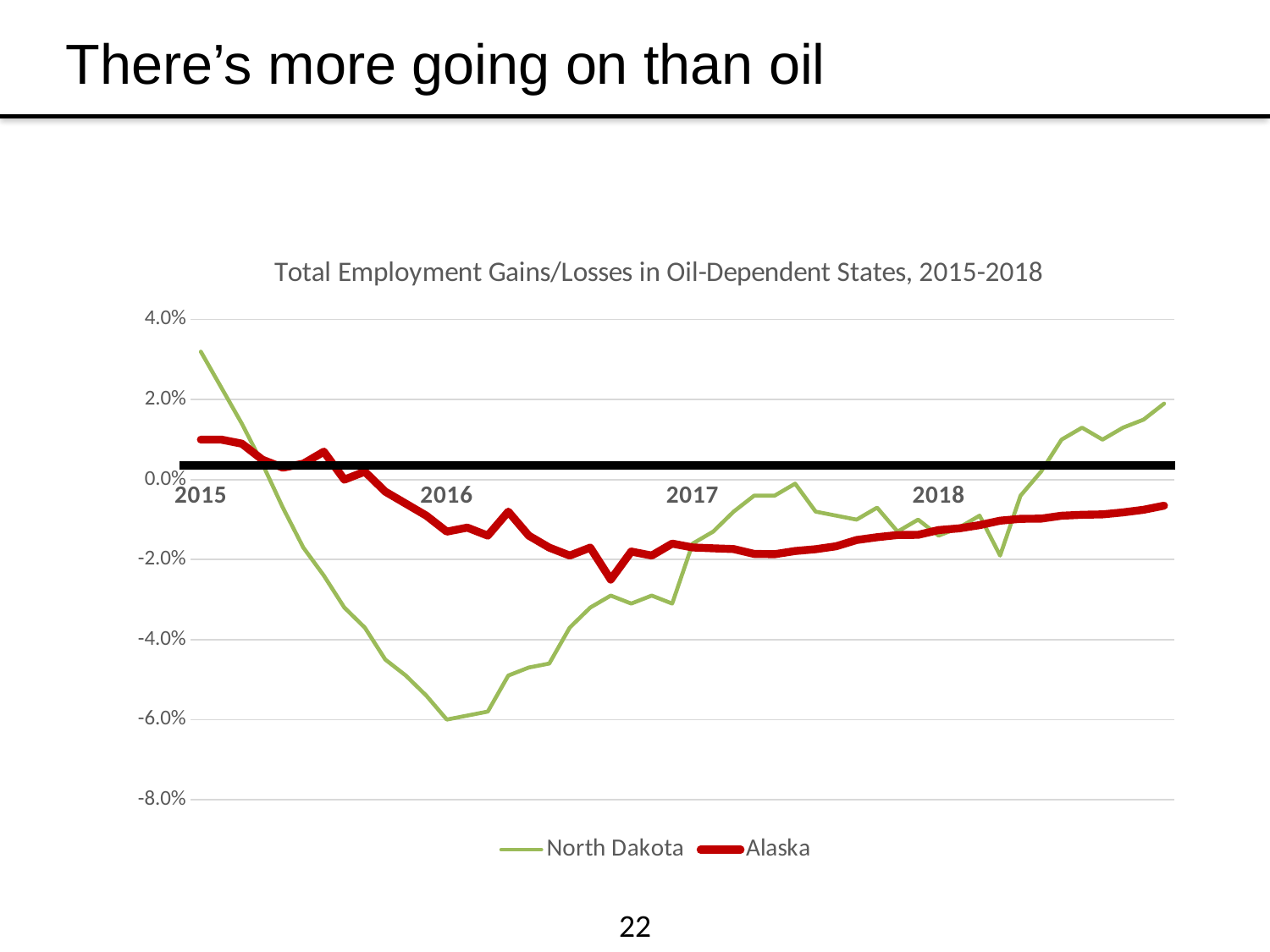
Is the lowest value reached by Alaska greater or less than -2.0%? less What is the title of the chart? Total Employment Gains/Losses in Oil-Dependent States, 2015-2018 Does the North Dakota line rise or fall between 2015 and 2016? fall How many series does the legend list? 2 At the 2016 mark, which series has the higher value, North Dakota or Alaska? Alaska Which series is drawn with the thick red line? Alaska Which series reaches the lowest value on the chart? North Dakota Is the value for Alaska at the end of the series greater or less than 0.0%? less How many year labels are shown on the x axis? 4 At the end of the series in 2018, which series has the higher value, North Dakota or Alaska? North Dakota What kind of chart is shown on the slide? line chart Is the value for North Dakota at the start of 2015 greater or less than 2.0%? greater